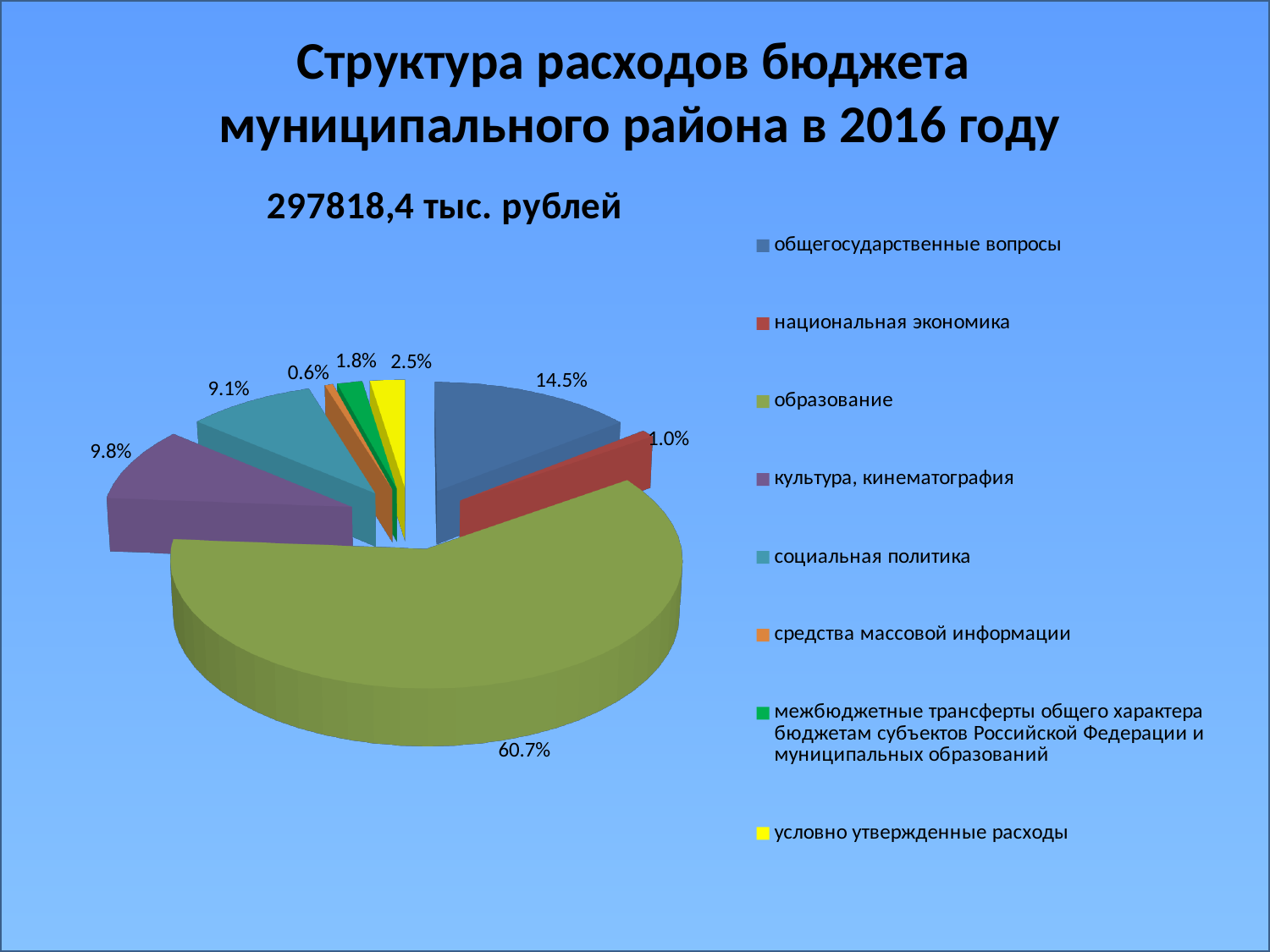
What share of the pie does образование take? 60.7% What kind of chart is shown on the slide? pie chart What is the value shown for социальная политика? 9.1% Which is larger, the share for социальная политика or the share for национальная экономика? социальная политика What total amount is given in the chart title above the pie? 297818,4 тыс. рублей What is the difference between the shares of общегосударственные вопросы and культура, кинематография? 4.7% What is the value shown for условно утвержденные расходы? 2.5% Which category has the smallest slice of the pie? средства массовой информации What is the value shown for общегосударственные вопросы? 14.5% How many categories does the legend list? 8 Which category has the largest slice of the pie? образование What is the value shown for культура, кинематография? 9.8%